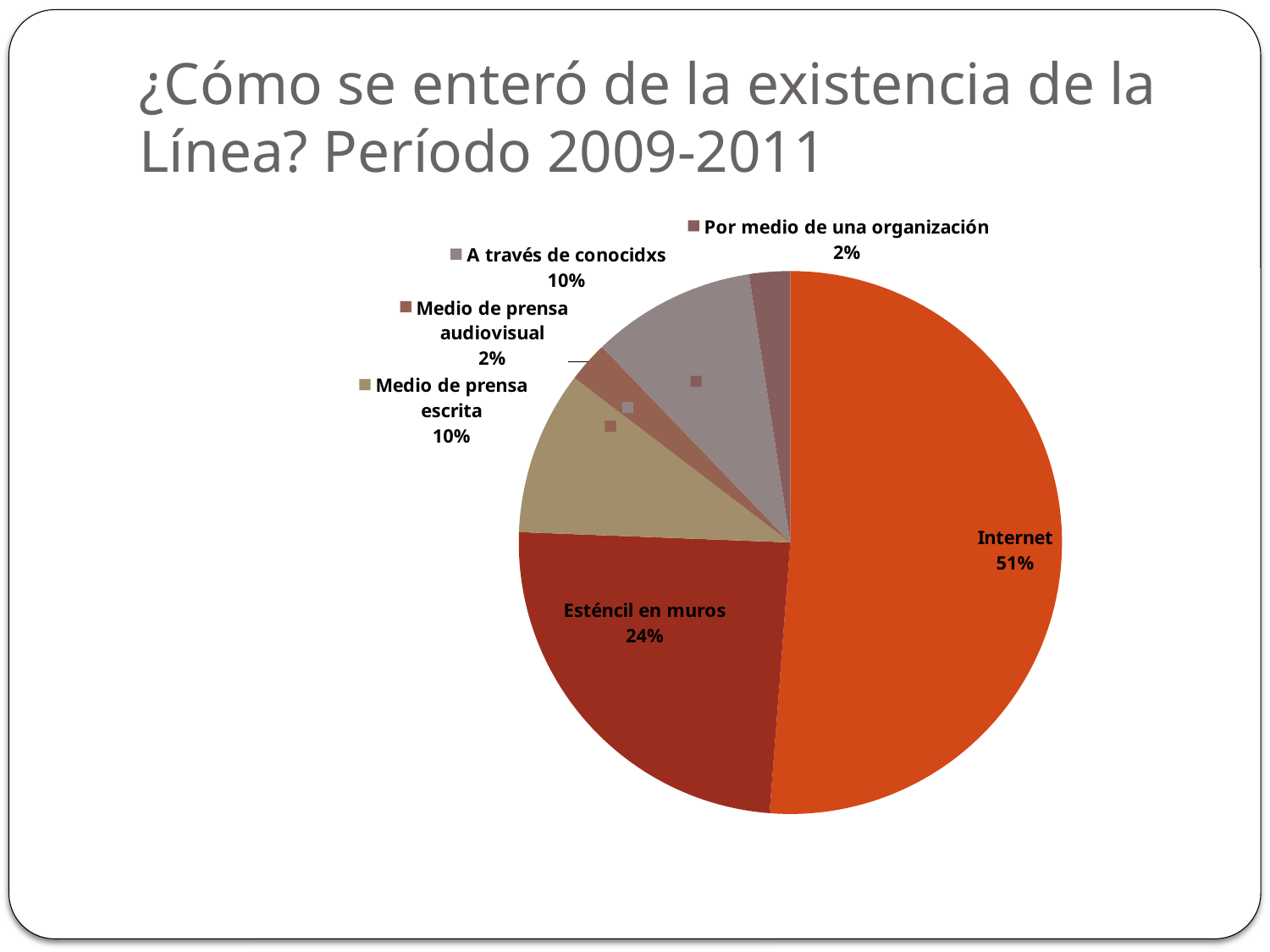
What is the combined percentage of Medio de prensa escrita and A través de conocidxs? 20% Which is larger, Esténcil en muros or A través de conocidxs? Esténcil en muros What kind of chart is shown on the slide? Pie chart Which category has the largest slice of the pie? Internet What percentage is shown for Por medio de una organización? 2% Which two categories each have a share of 2%? Medio de prensa audiovisual and Por medio de una organización What is the difference in percentage points between Internet and Esténcil en muros? 27 What percentage is shown for Medio de prensa escrita? 10% What percentage is shown for Esténcil en muros? 24% What share of the pie does Internet account for? 51% How many categories are shown in the pie chart? 6 What is the title of the slide? ¿Cómo se enteró de la existencia de la Línea? Período 2009-2011